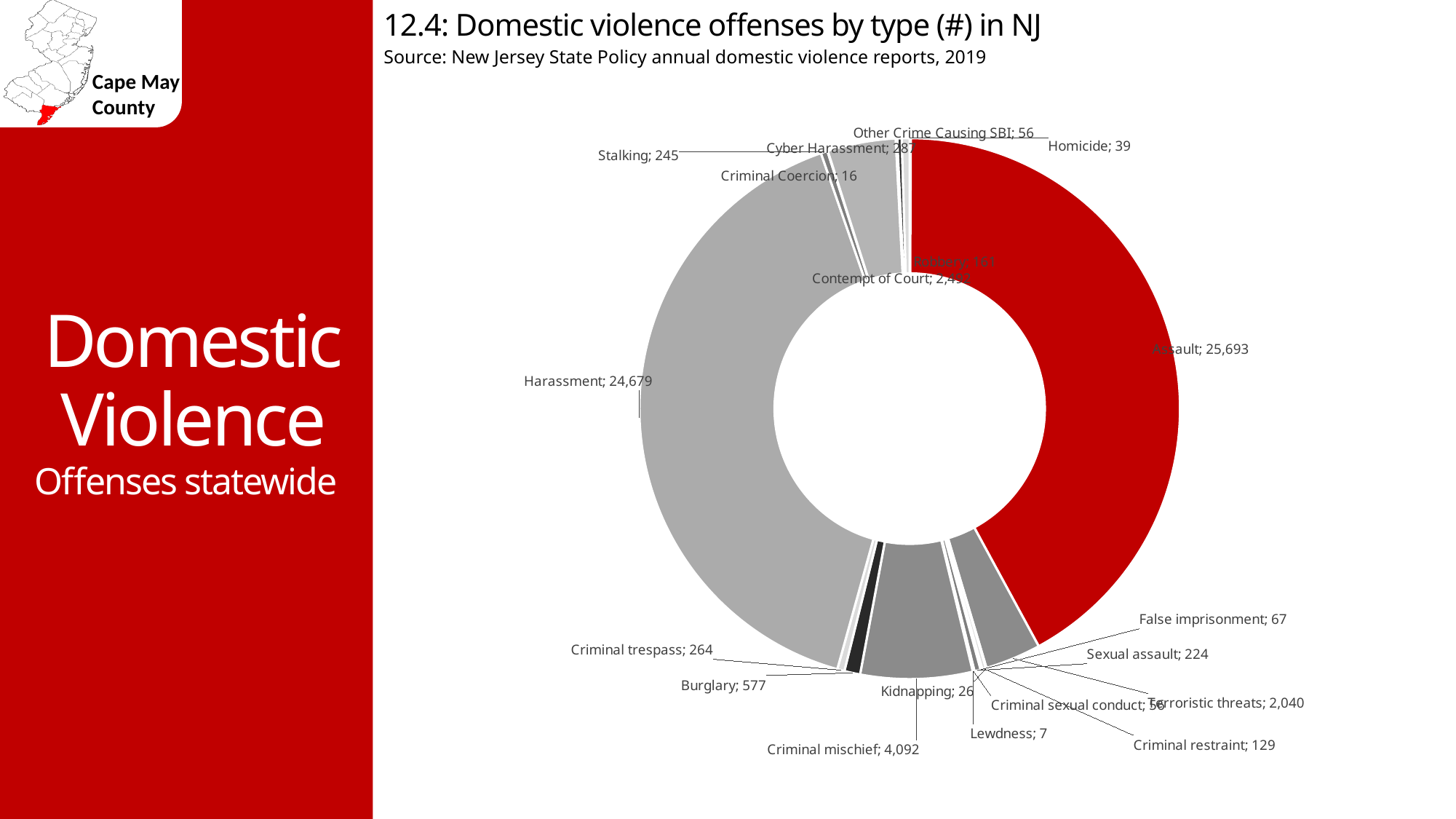
Which offense type has the smallest value? Lewdness What is the difference between Criminal mischief and Terroristic threats? 2,052 What colour is the Assault slice? red How many domestic violence offenses of type Assault are shown? 25,693 Which offense type has the largest slice? Assault What is the difference between the Assault and Harassment values? 1,014 What is the value for Harassment? 24,679 What is the value for Criminal mischief? 4,092 Which is larger, Homicide or False imprisonment? False imprisonment What is the value for Terroristic threats? 2,040 Which is larger, Burglary or Criminal trespass? Burglary What kind of chart is shown on the slide? doughnut chart